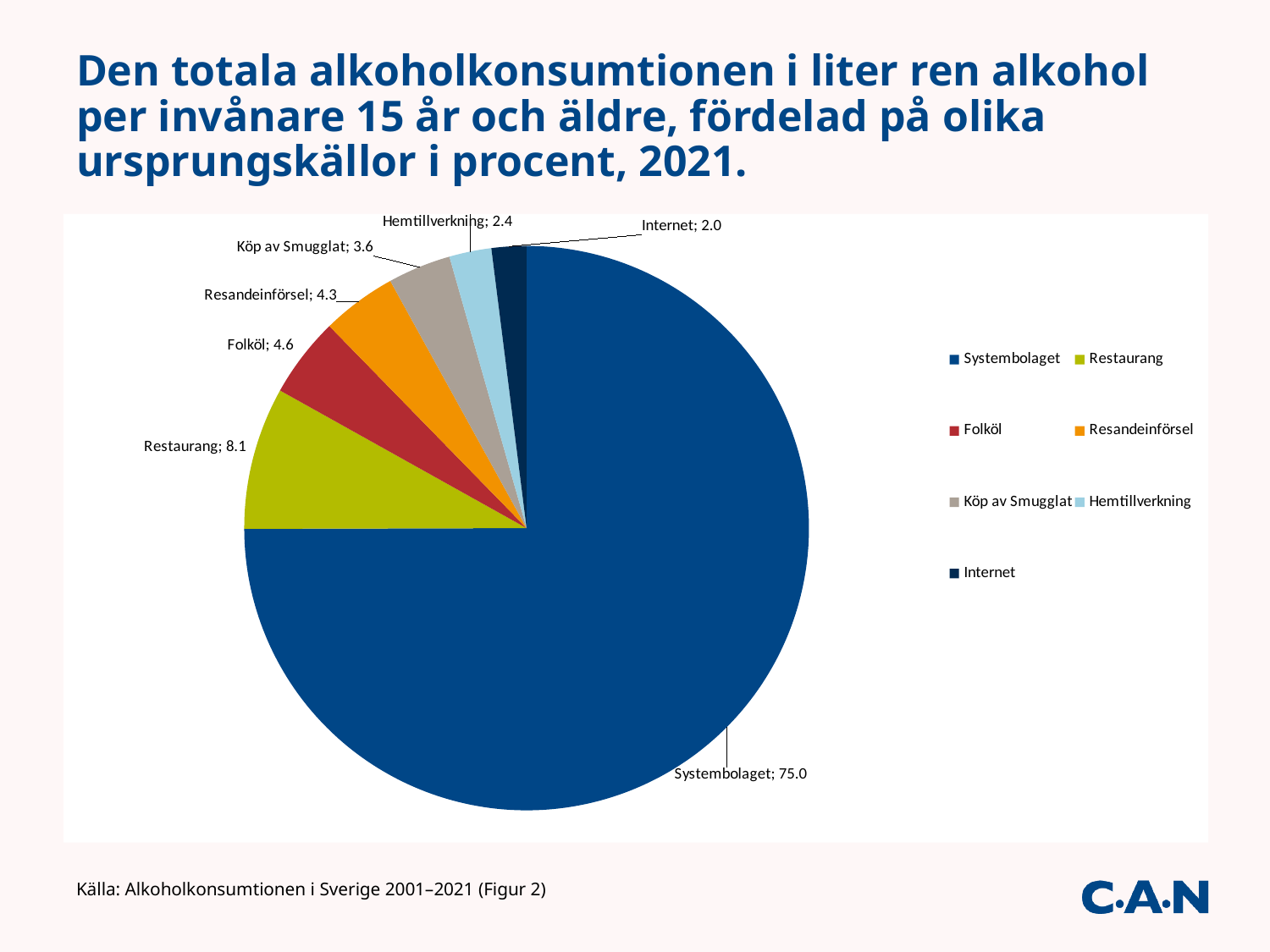
What kind of chart is shown on the slide? pie chart How many entries does the legend list? 7 What is the difference between the values for Restaurang and Folköl? 3.5 How many categories does the pie chart have? 7 What is the value for Restaurang? 8.1 What is the value for Systembolaget? 75.0 What is the value for Folköl? 4.6 What is the value for Köp av Smugglat? 3.6 Which category has the largest slice? Systembolaget Which category has the smallest slice? Internet Which is larger, Resandeinförsel or Hemtillverkning? Resandeinförsel What colour is the Restaurang slice? yellow-green